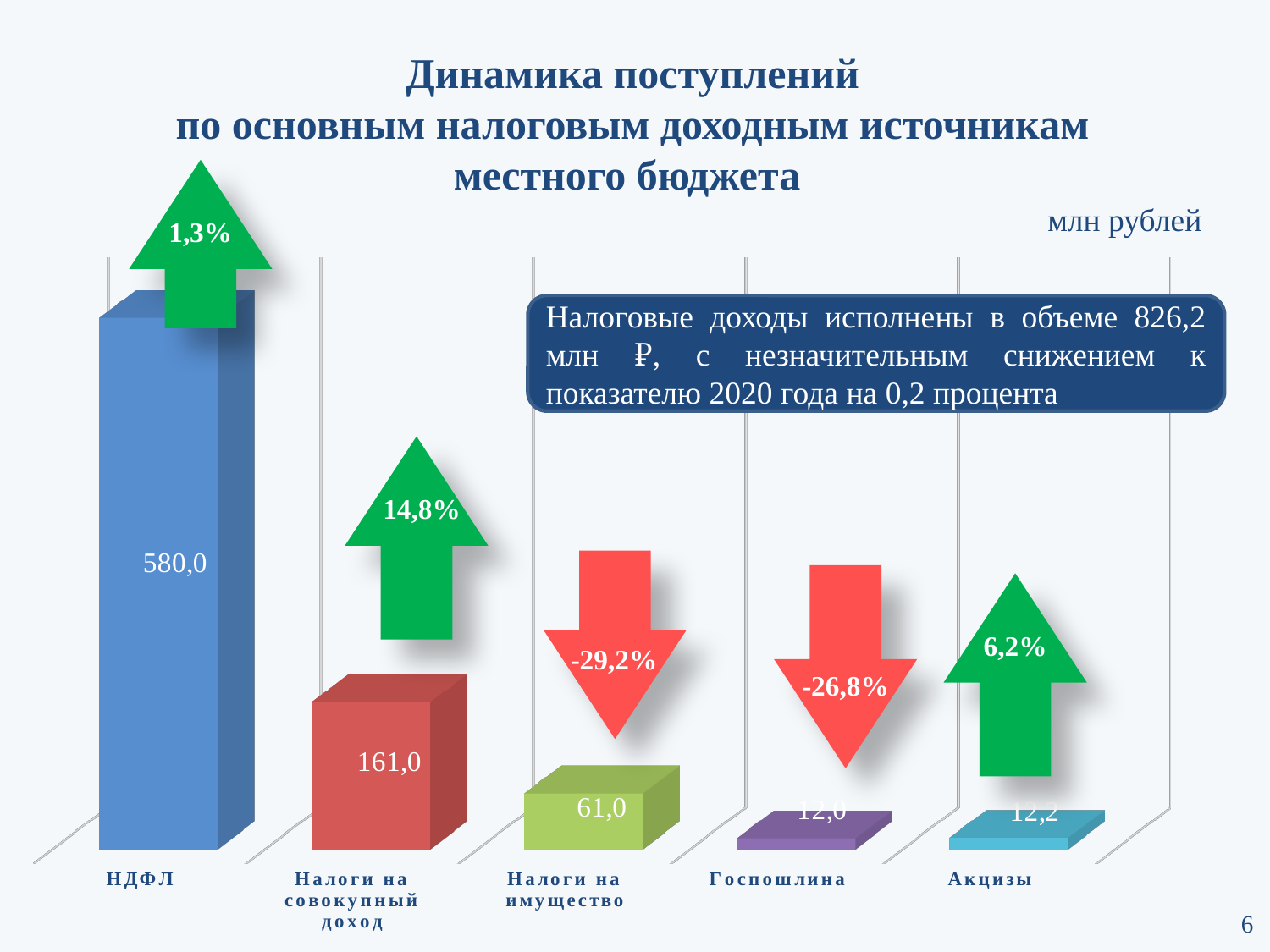
What is the difference between the values for Налоги на совокупный доход and Налоги на имущество? 100,0 What is the value for Акцизы? 12,2 What is the value for Госпошлина? 12,0 Which is larger, the value for Налоги на совокупный доход or the value for Налоги на имущество? Налоги на совокупный доход What is the value for НДФЛ? 580,0 What percentage change is shown on the arrow above Налоги на имущество? -29,2% What is the value for Налоги на имущество? 61,0 What kind of chart is shown on the slide? bar chart What is the difference between the values for НДФЛ and Налоги на совокупный доход? 419,0 Which category has the highest value? НДФЛ What is the value for Налоги на совокупный доход? 161,0 How many categories are shown in the chart? 5